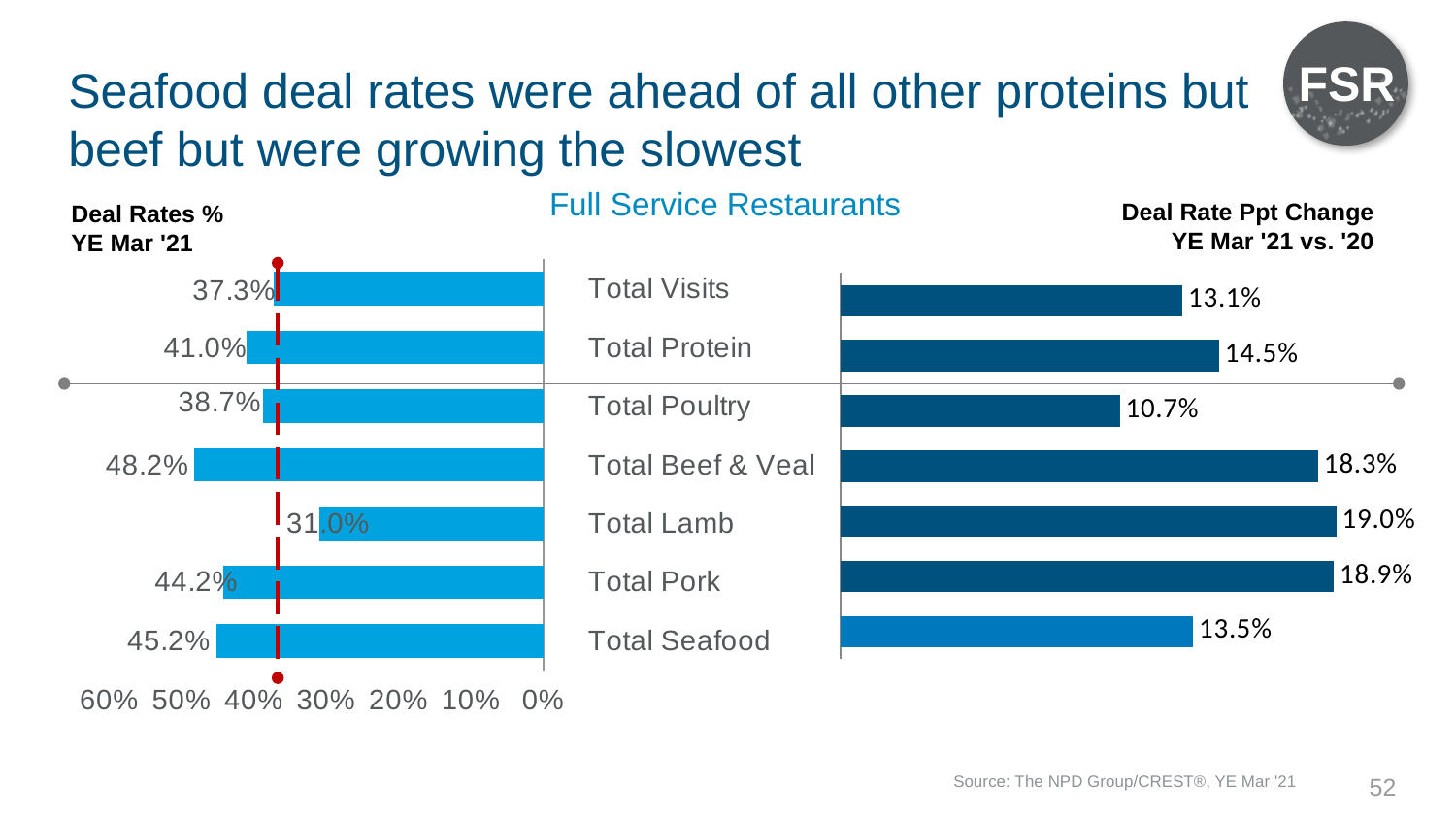
What type of chart is the Deal Rate Ppt Change YE Mar '21 vs. '20 chart? Bar chart In the Deal Rate Ppt Change YE Mar '21 vs. '20 chart, which is larger: Total Protein or Total Visits? Total Protein In the Deal Rates % YE Mar '21 chart, which category has the lowest deal rate? Total Lamb In the Deal Rate Ppt Change YE Mar '21 vs. '20 chart, what is the value for Total Seafood? 13.5% In the Deal Rates % YE Mar '21 chart, which category has the highest deal rate? Total Beef & Veal In the Deal Rates % YE Mar '21 chart, what is the difference between the deal rates for Total Beef & Veal and Total Seafood? 3.0% In the Deal Rate Ppt Change YE Mar '21 vs. '20 chart, what is the difference between Total Beef & Veal and Total Seafood? 4.8% In the Deal Rates % YE Mar '21 chart, what is the deal rate for Total Seafood? 45.2% How many categories are shown in the Deal Rates % YE Mar '21 chart? 7 In the Deal Rates % YE Mar '21 chart, what is the deal rate for Total Lamb? 31.0% In the Deal Rate Ppt Change YE Mar '21 vs. '20 chart, what is the value for Total Poultry? 10.7% In the Deal Rate Ppt Change YE Mar '21 vs. '20 chart, which category has the lowest value? Total Poultry